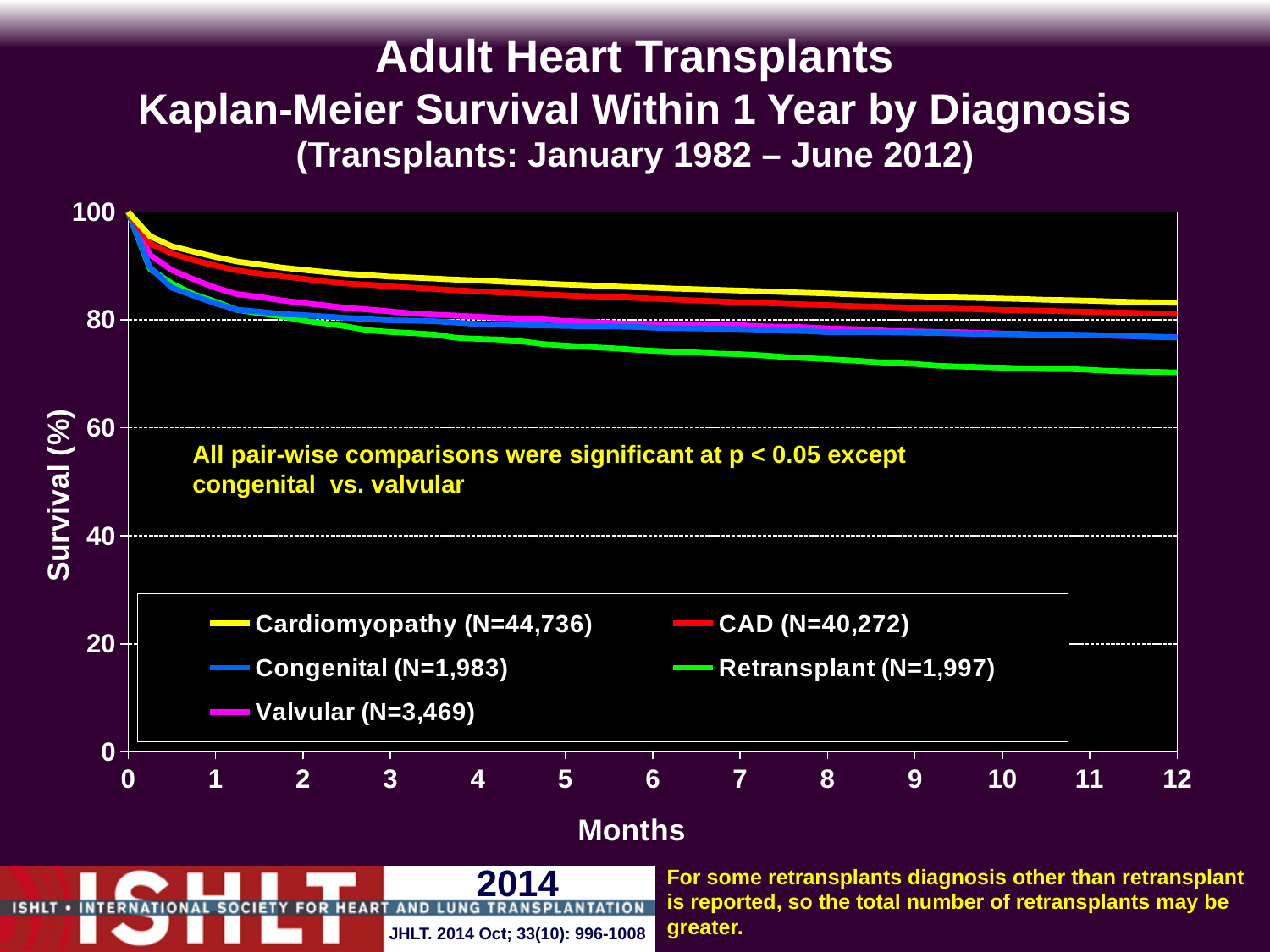
Which diagnosis group has the highest survival at 12 months? Cardiomyopathy What colour is the line for Congenital? Blue What is the number of patients (N) in the Cardiomyopathy group according to the legend? 44,736 At 12 months, which has higher survival: CAD or Retransplant? CAD Is the survival for CAD at 6 months greater or less than 80? greater How many series does the legend list? 5 What kind of chart is shown on the slide? Line chart Is the survival for Cardiomyopathy at 12 months greater or less than 80? greater What is the number of patients (N) in the Valvular group according to the legend? 3,469 Do the survival curves rise or fall as months increase? Fall Is the survival for Retransplant at 12 months greater or less than 80? less Which diagnosis group has the lowest survival at 12 months? Retransplant